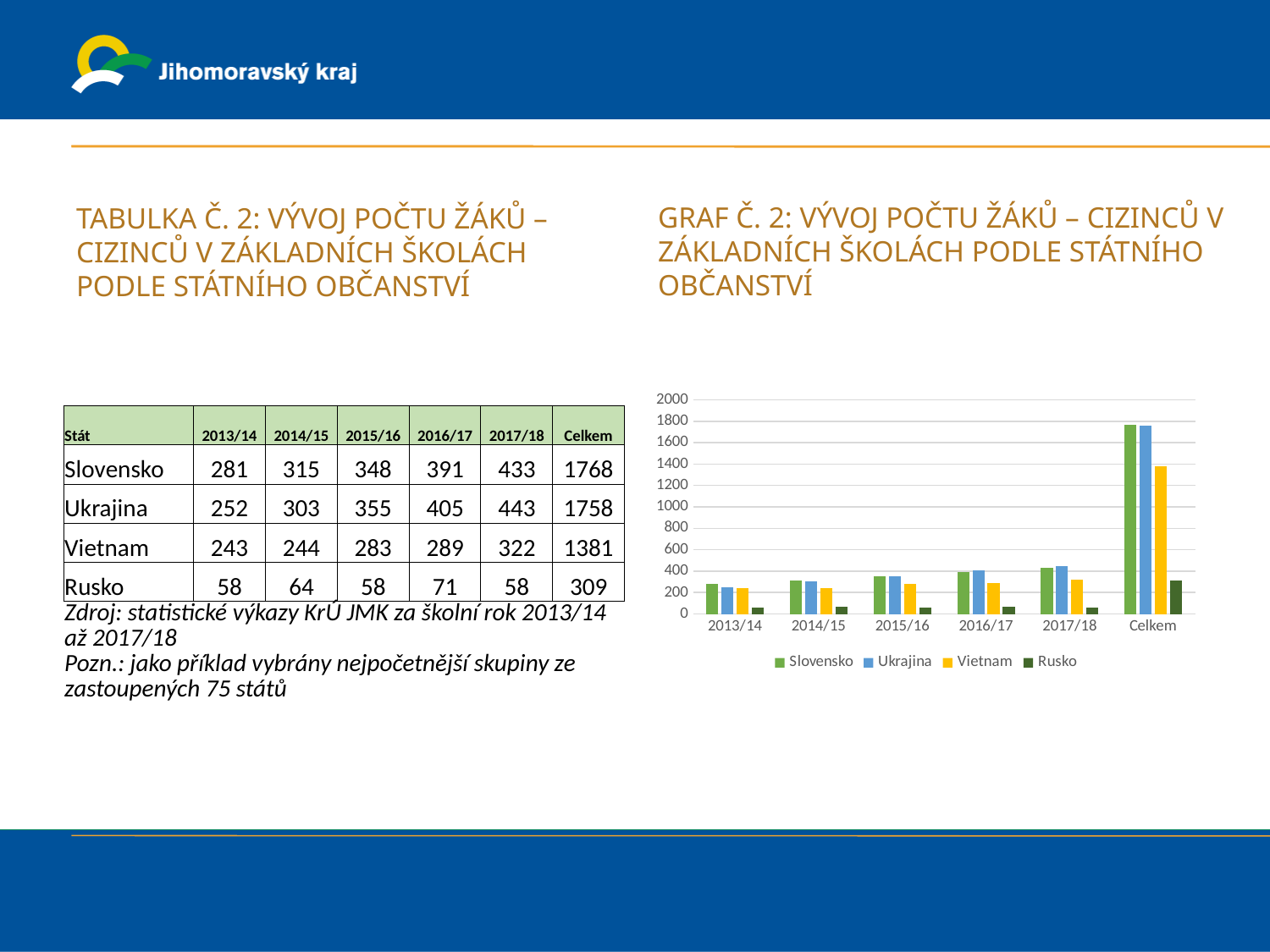
What is the value for Slovensko in 2017/18, as given in the table? 433 Which series has the highest value in the Celkem category? Slovensko What is the Celkem value for Rusko, as given in the table? 309 What kind of chart is shown on the slide? bar chart Which series has the lowest value in every category of the chart? Rusko How many series does the chart legend list? 4 Is the value for Ukrajina in 2017/18 greater or less than 400? greater Does the value for Slovensko rise or fall from 2013/14 to 2017/18? rise Is the value for Rusko in 2017/18 greater or less than 200? less In 2017/18, which is larger: the value for Ukrajina or the value for Vietnam? Ukrajina How many categories are shown along the x axis of the chart? 6 Is the value for Vietnam in the Celkem category greater or less than 1200? greater